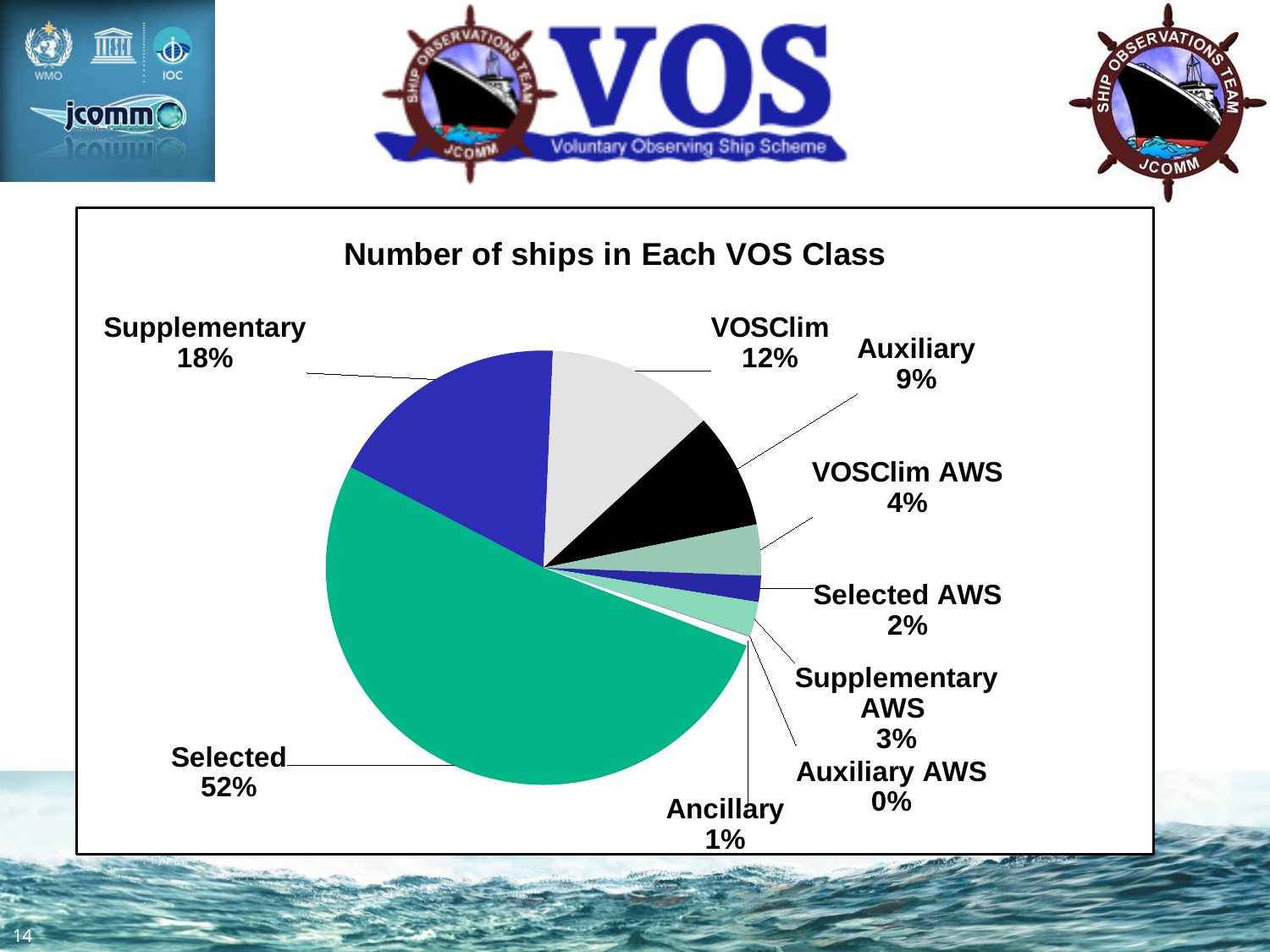
What is the difference in percentage points between VOSClim AWS and Selected AWS? 2 Which VOS class has the largest slice of the pie? Selected What share of the pie does the Supplementary class have? 18% What is the title of the chart? Number of ships in Each VOS Class What type of chart is shown on the slide? pie chart What share of the pie does the Selected class have? 52% Which VOS class has the smallest slice of the pie? Auxiliary AWS What share of the pie does VOSClim have? 12% What is the difference in percentage points between Selected and Supplementary? 34 How many VOS classes are shown in the pie chart? 9 Which is larger, the share for VOSClim or the share for Auxiliary? VOSClim What percentage is shown for Auxiliary AWS? 0%